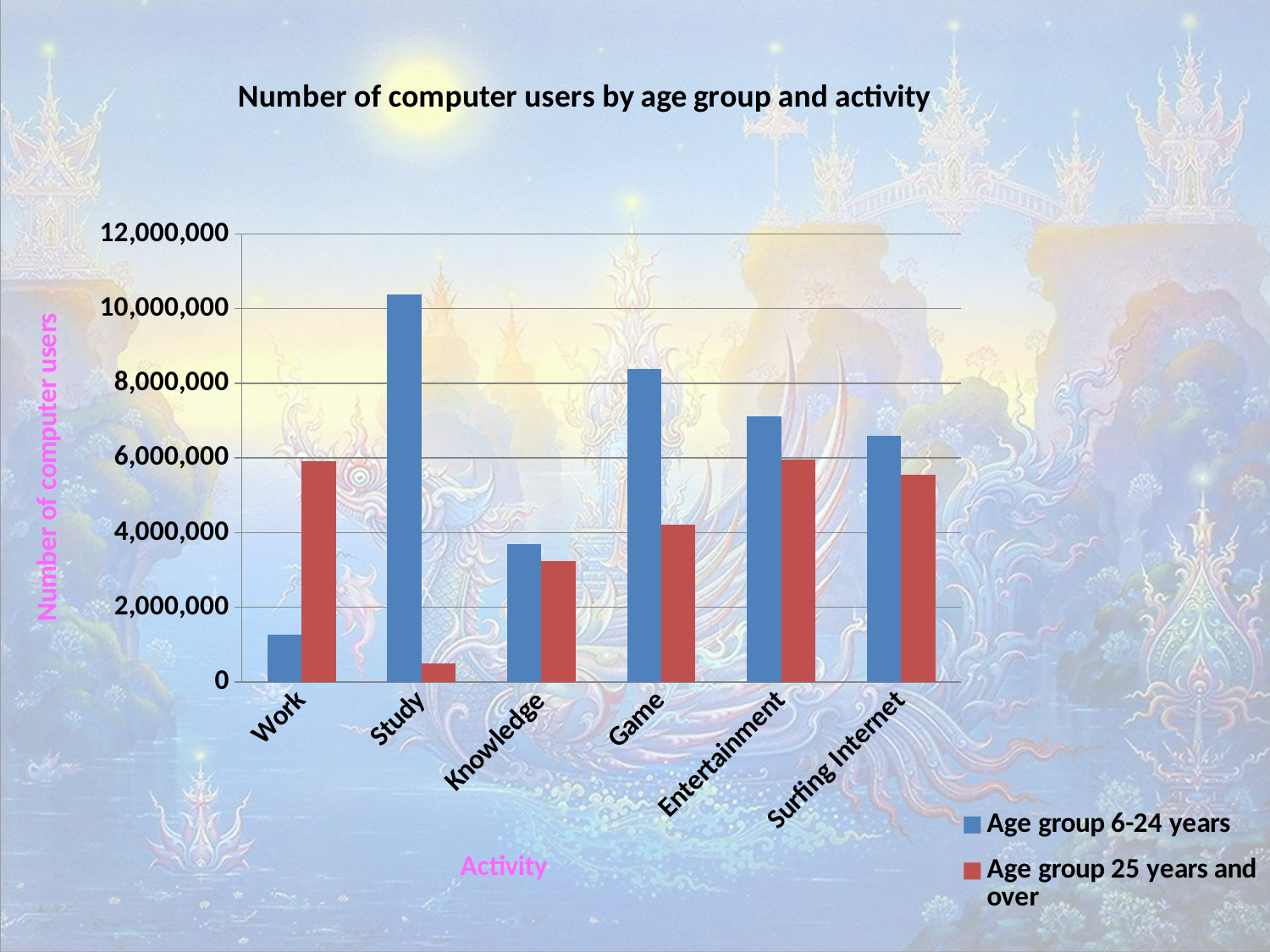
For the Game activity, which age group has more computer users? Age group 6-24 years For the Work activity, which age group has more computer users? Age group 25 years and over How many activity categories are shown on the x axis? 6 What kind of chart is shown on the slide? bar chart Is the value for Study in the age group 6-24 years greater or less than 10,000,000? greater Which activity has the highest number of computer users for the age group 6-24 years? Study Which activity has the lowest number of computer users for the age group 6-24 years? Work What is the title of the chart? Number of computer users by age group and activity Is the value for Game in the age group 6-24 years greater or less than 8,000,000? greater How many series does the legend list? 2 Is the value for Knowledge in the age group 6-24 years greater or less than 4,000,000? less Which activity has the lowest number of computer users for the age group 25 years and over? Study